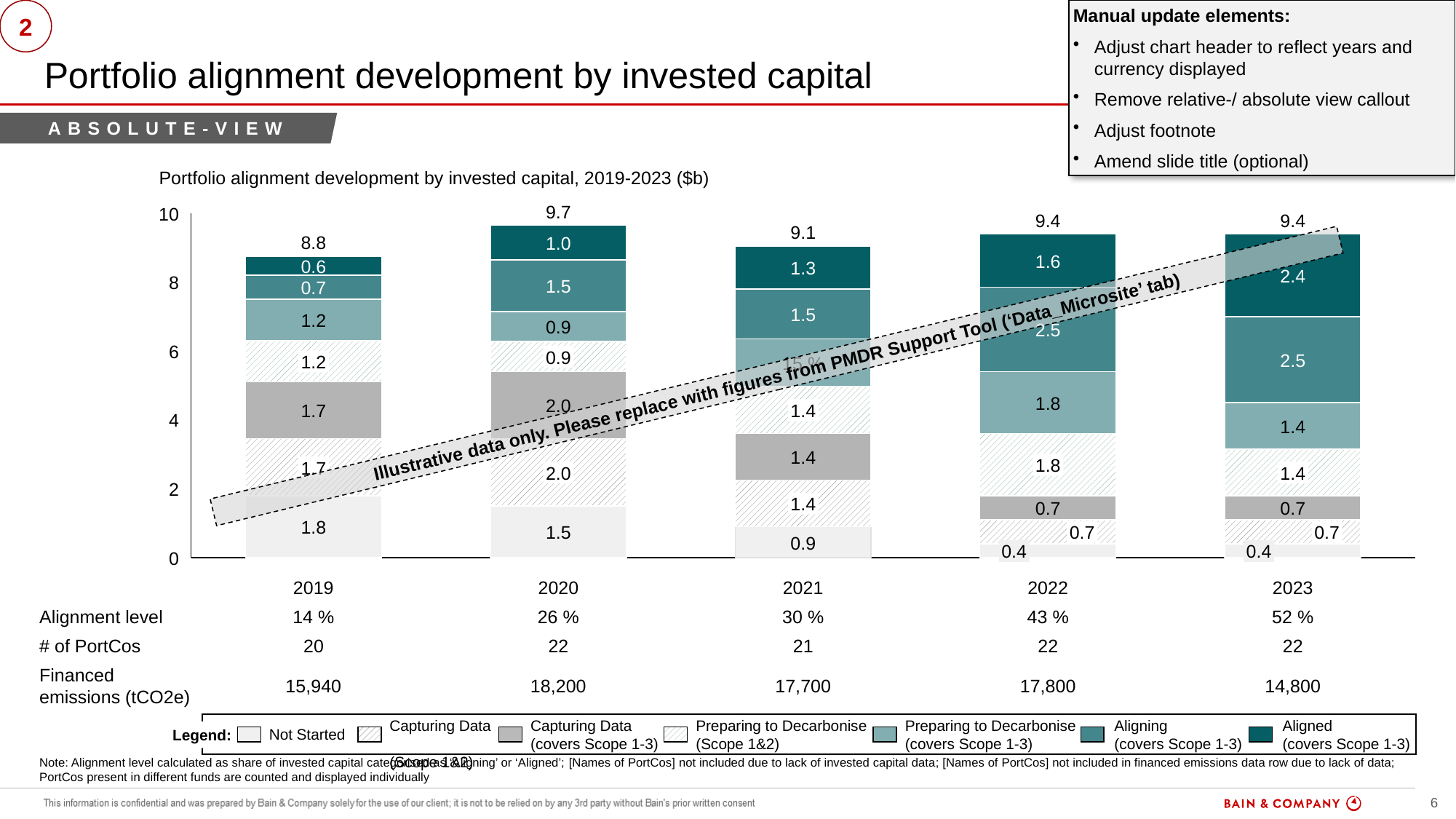
Which is larger: the 'Aligned (covers Scope 1-3)' segment in 2022 or in 2021? 2022 How many series does the legend list? 7 How many years are shown on the x axis? 5 Does the 'Aligned (covers Scope 1-3)' segment rise or fall from 2019 to 2023? Rise What is the difference between the total for 2020 and the total for 2019? 0.9 What kind of chart is shown? Stacked bar chart What is the value of the 'Aligned (covers Scope 1-3)' segment for 2023? 2.4 Which year has the lowest total invested capital? 2019 What is the value of the 'Not Started' segment for 2019? 1.8 Which year has the highest total invested capital? 2020 What is the total invested capital shown for 2020? 9.7 What is the value of the 'Aligned (covers Scope 1-3)' segment for 2019? 0.6